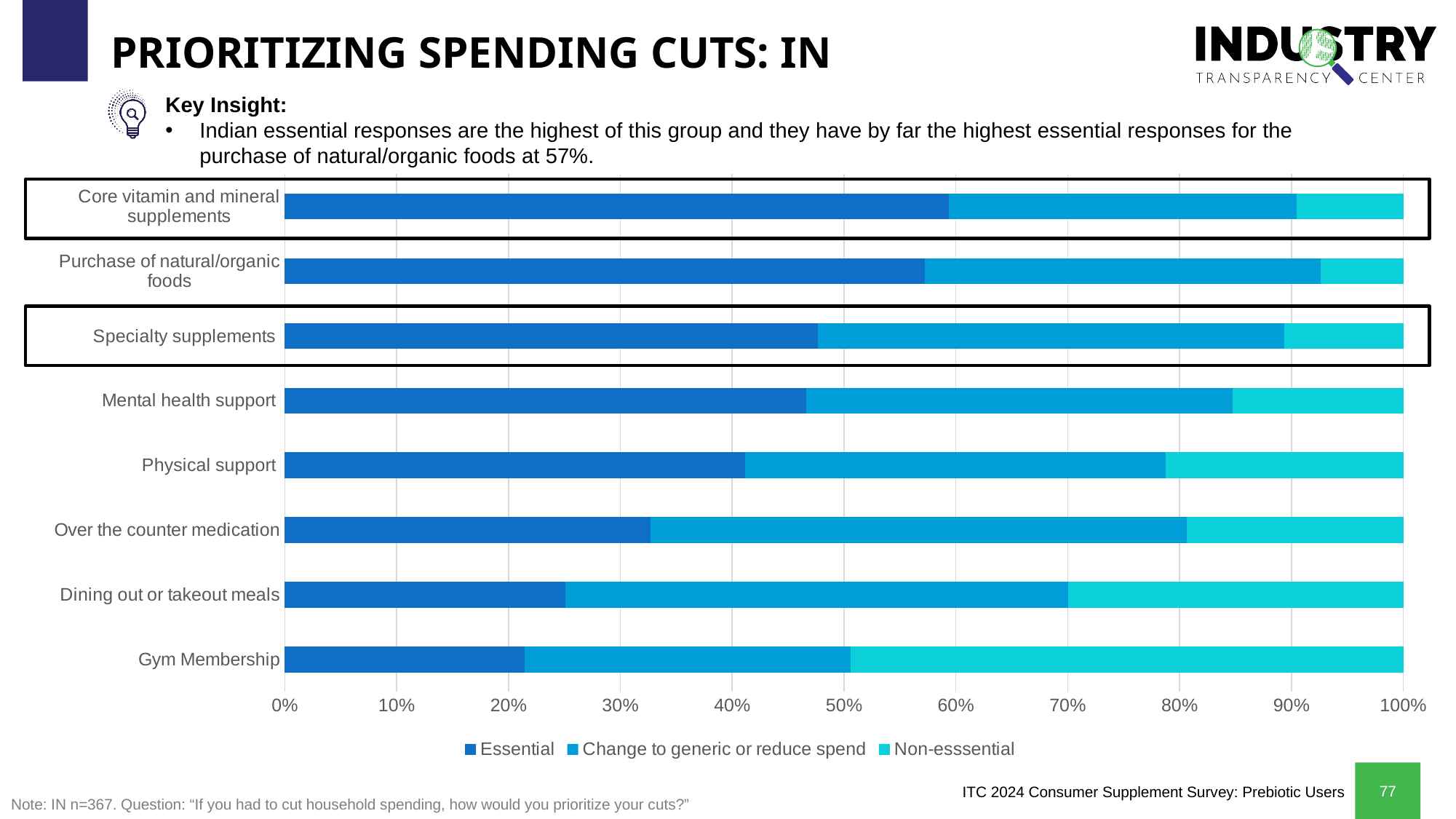
Is the Essential value for Mental health support greater or less than 50%? less How many series does the chart legend list? 3 How many spending categories are plotted on the chart? 8 Which has a larger Essential share: Dining out or takeout meals or Gym Membership? Dining out or takeout meals Is the Essential value for Over the counter medication greater or less than 30%? greater What are the three legend entries of the chart? Essential; Change to generic or reduce spend; Non-esssential Which category has the lowest Essential share? Gym Membership Is the Essential value for Gym Membership greater or less than 30%? less Which category has the highest Essential share? Core vitamin and mineral supplements What kind of chart is shown on the slide? Bar chart Which has a larger Essential share: Physical support or Over the counter medication? Physical support